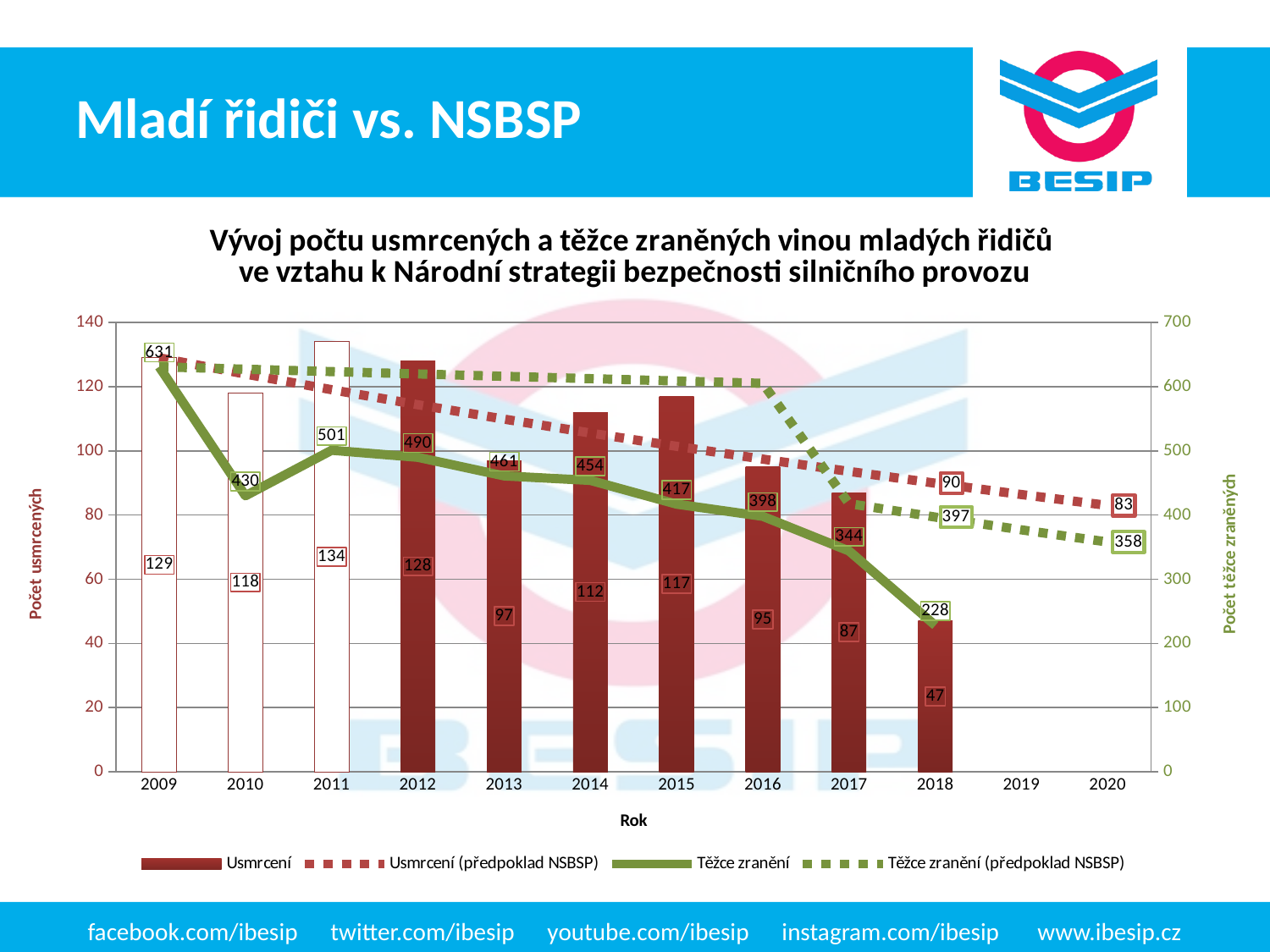
How many series does the legend list? 4 What is the value of Usmrcení (number killed) in 2018? 47 What is the Těžce zranění (předpoklad NSBSP) value shown for 2020? 358 Which is larger, the Těžce zranění value in 2010 or in 2011? 2011 What is the difference between the Usmrcení values for 2012 and 2013? 31 What is the Usmrcení (předpoklad NSBSP) value shown for 2020? 83 What is the value of Těžce zranění (seriously injured) in 2009? 631 Which year has the lowest Usmrcení value? 2018 What is the overall trend of the Těžce zranění line from 2009 to 2018? Falling What is the label of the left vertical axis? Počet usmrcených What is the value of Usmrcení in 2011? 134 Which year has the highest Těžce zranění value? 2009